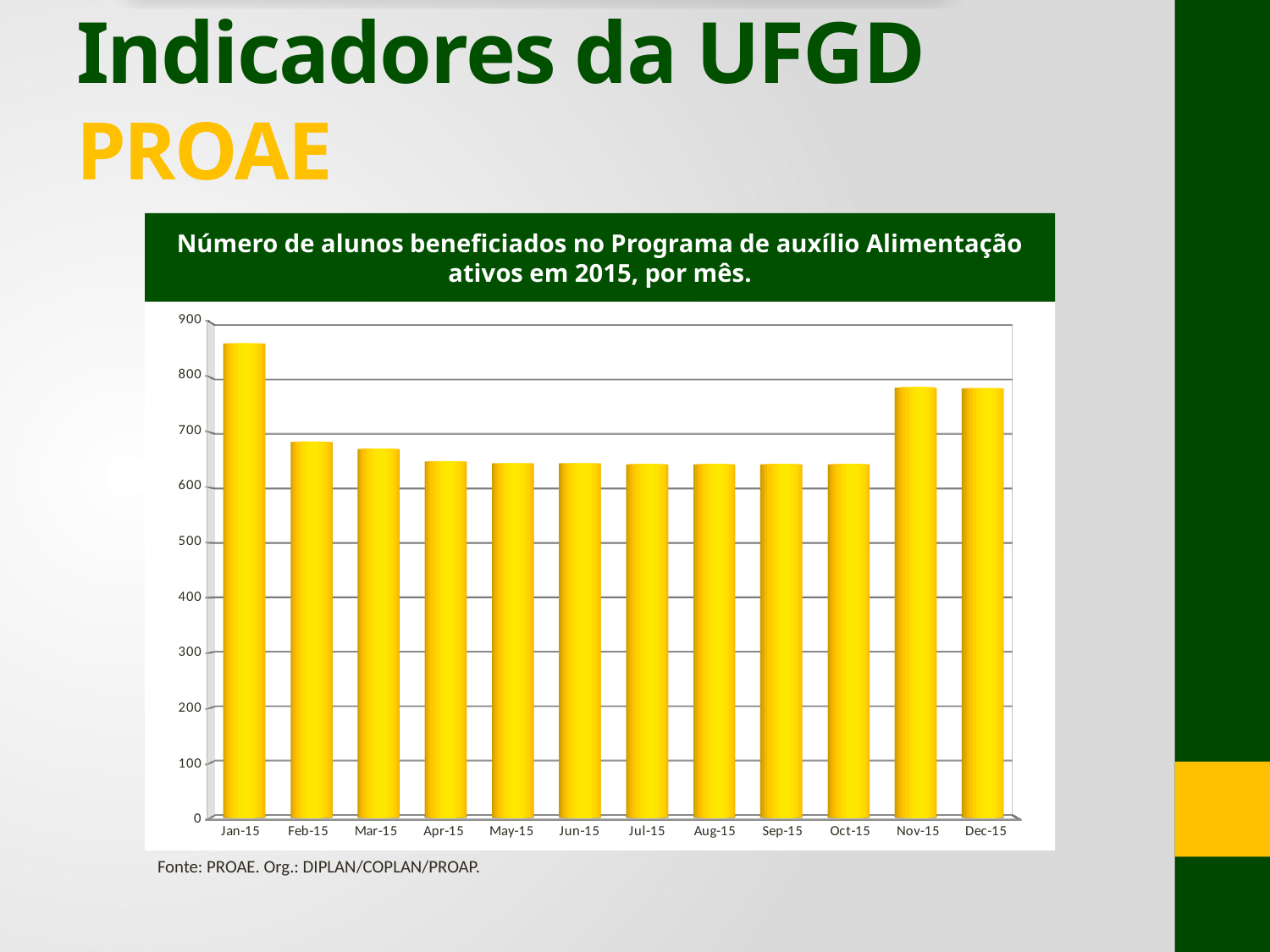
Is the value for Jan-15 greater or less than 800? greater Do the values rise or fall from Jan-15 to Oct-15? fall Is the value for Feb-15 greater or less than 700? less How many months are shown on the x axis of the chart? 12 Which month has the highest number of students benefited? Jan-15 What is the title of the chart? Número de alunos beneficiados no Programa de auxílio Alimentação ativos em 2015, por mês. Which is larger, the value for Jan-15 or the value for Feb-15? Jan-15 Is the value for Jun-15 greater or less than 600? greater Which is larger, the value for Oct-15 or the value for Nov-15? Nov-15 What kind of chart is shown on the slide? bar chart